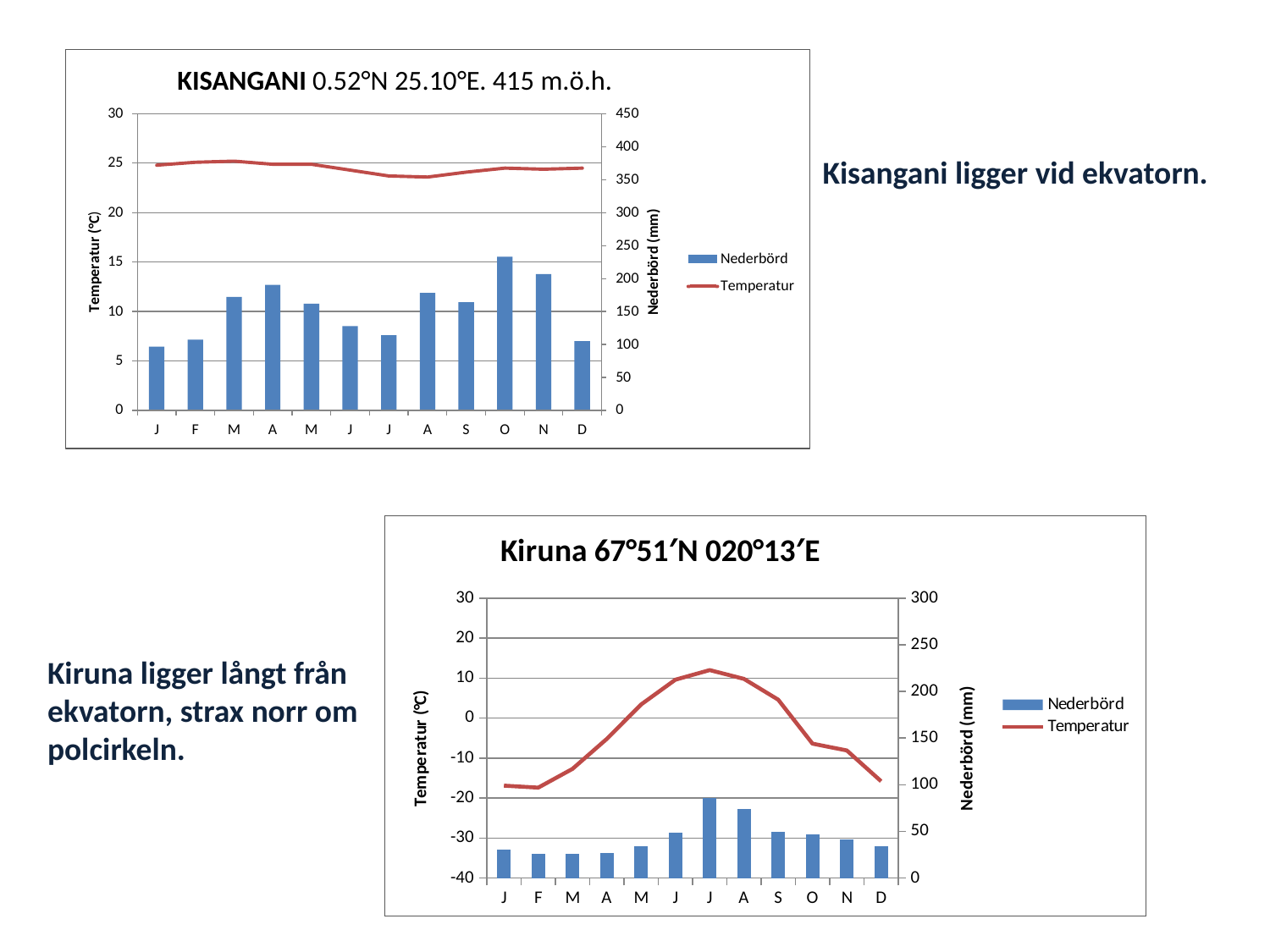
In the Kiruna chart, does the temperature rise or fall from January to July? rise In the Kisangani chart, which month has the highest precipitation (Nederbörd) bar? O In the Kisangani chart, is the temperature in January greater or less than 20 °C? greater How many months are shown on the x axis of the Kiruna chart? 12 What colour is the Temperatur line in the Kiruna chart? Red How many series does the legend of the Kisangani chart list? 2 In the Kisangani chart, is the precipitation for October greater or less than 200 mm? greater In the Kiruna chart, which month has the highest temperature? J (July) In the Kisangani chart, is the precipitation for January greater or less than 150 mm? less In the Kisangani chart, is the precipitation bar for October larger or smaller than the bar for January? larger In the Kiruna chart, which month has the highest precipitation (Nederbörd) bar? J (July)